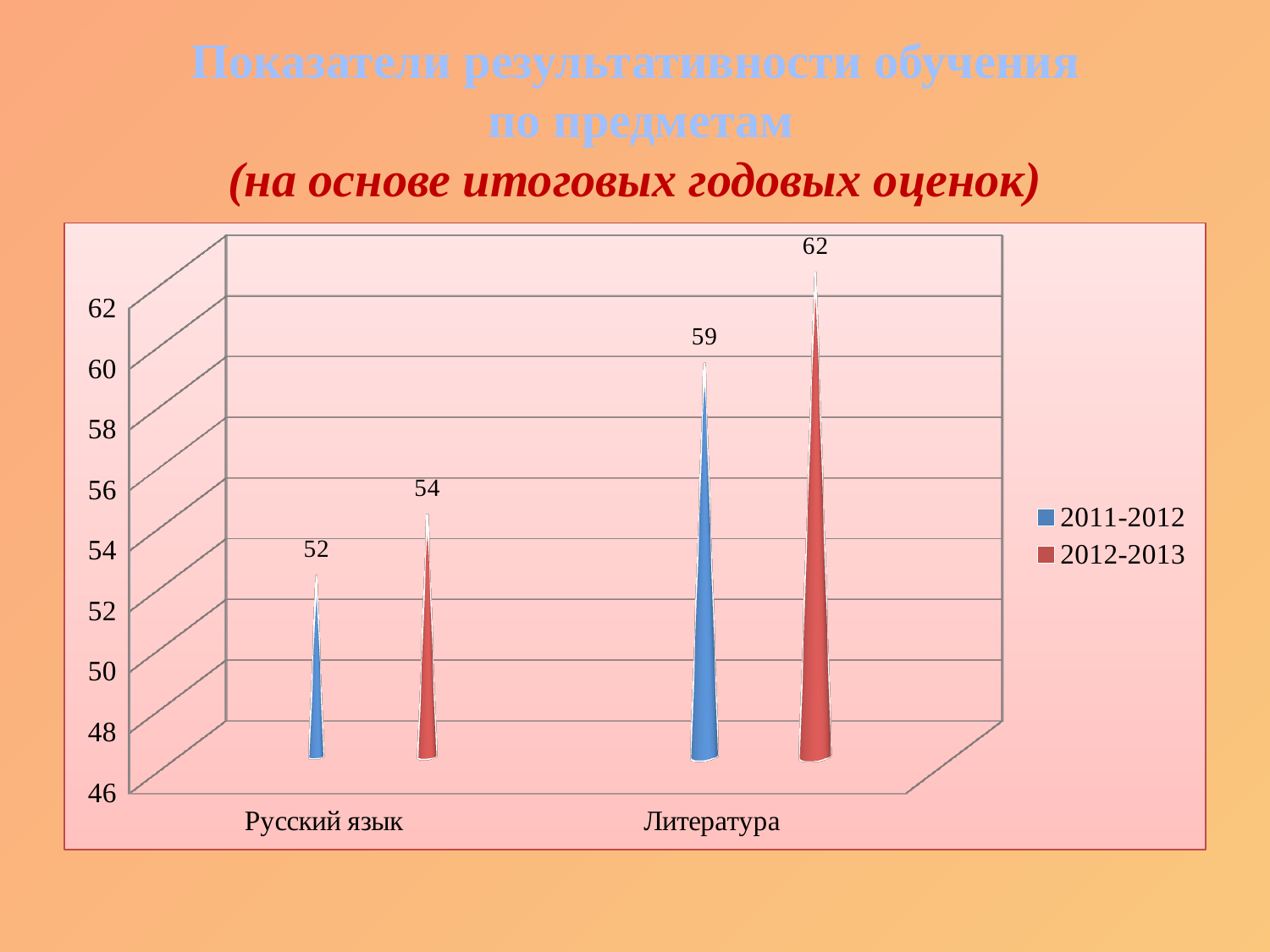
How many categories are shown on the x axis? 2 Which is larger for Литература: the 2011-2012 value or the 2012-2013 value? 2012-2013 What kind of chart is shown on the slide? bar chart What is the difference between the 2012-2013 and 2011-2012 values for Русский язык? 2 What is the value for Литература in the 2011-2012 series? 59 Which category has the lowest value in the 2011-2012 series? Русский язык What is the value for Литература in the 2012-2013 series? 62 How many series does the legend list? 2 Which category has the highest value in the 2012-2013 series? Литература What is the value for Русский язык in the 2011-2012 series? 52 What is the difference between the 2012-2013 and 2011-2012 values for Литература? 3 What is the value for Русский язык in the 2012-2013 series? 54